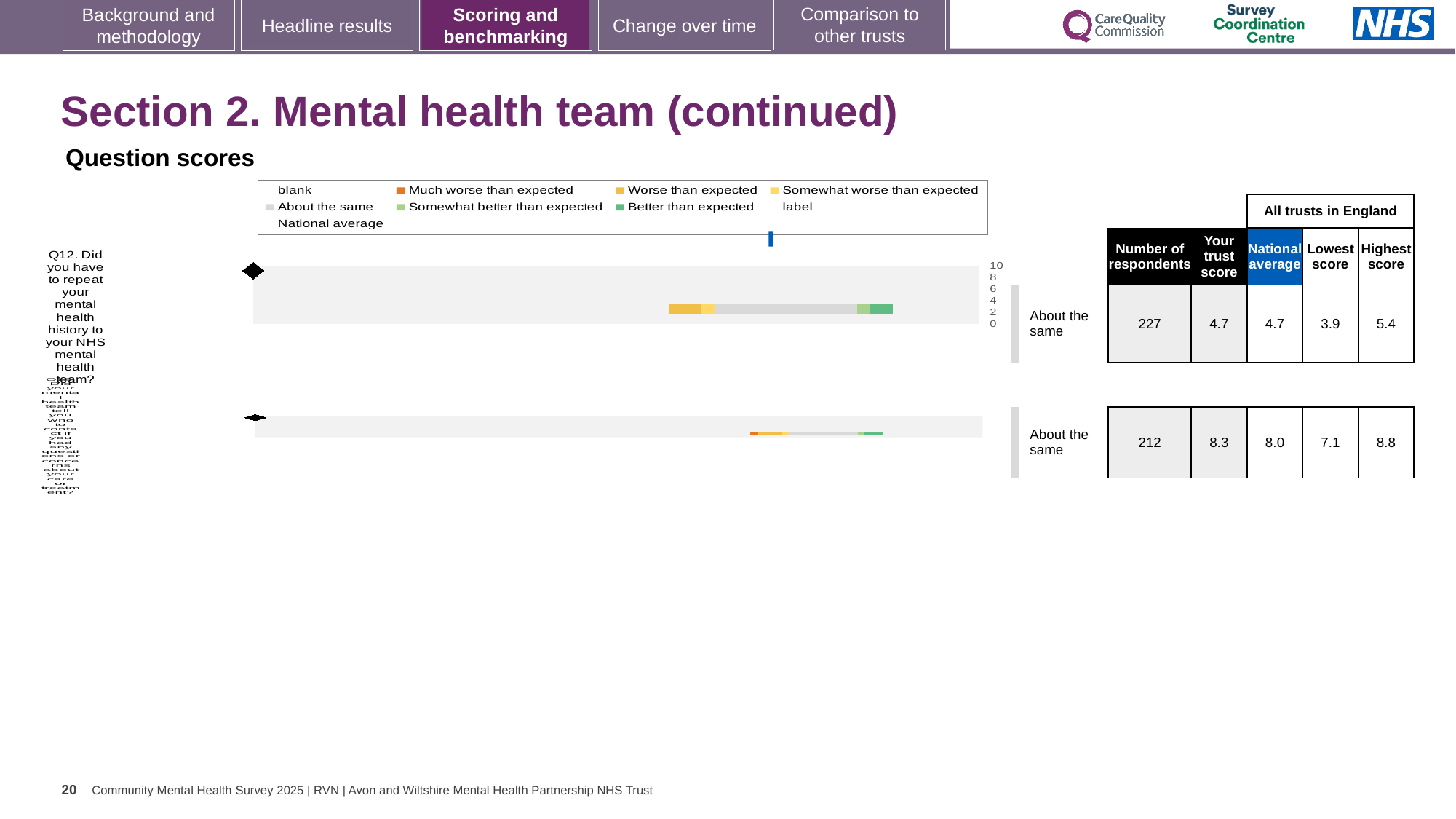
What is the number of respondents for Q12? 227 What is the trust score for the second (lower) question row in the chart? 8.3 How many entries does the legend of the question scores chart list? 9 What is the trust score for Q12 (repeating mental health history to the NHS mental health team)? 4.7 What is the national average for Q12? 4.7 How many question rows are plotted in the question scores chart? 2 What benchmark category is shown for Q12 in the chart? About the same What is the highest score among all trusts in England for Q12? 5.4 What is the lowest score among all trusts in England for Q12? 3.9 What is the difference between the trust score and the national average for the second (lower) question row? 0.3 What kind of chart is used to show the question scores on this slide? bar chart Which question row has the higher trust score, Q12 or the second (lower) row? the second (lower) row